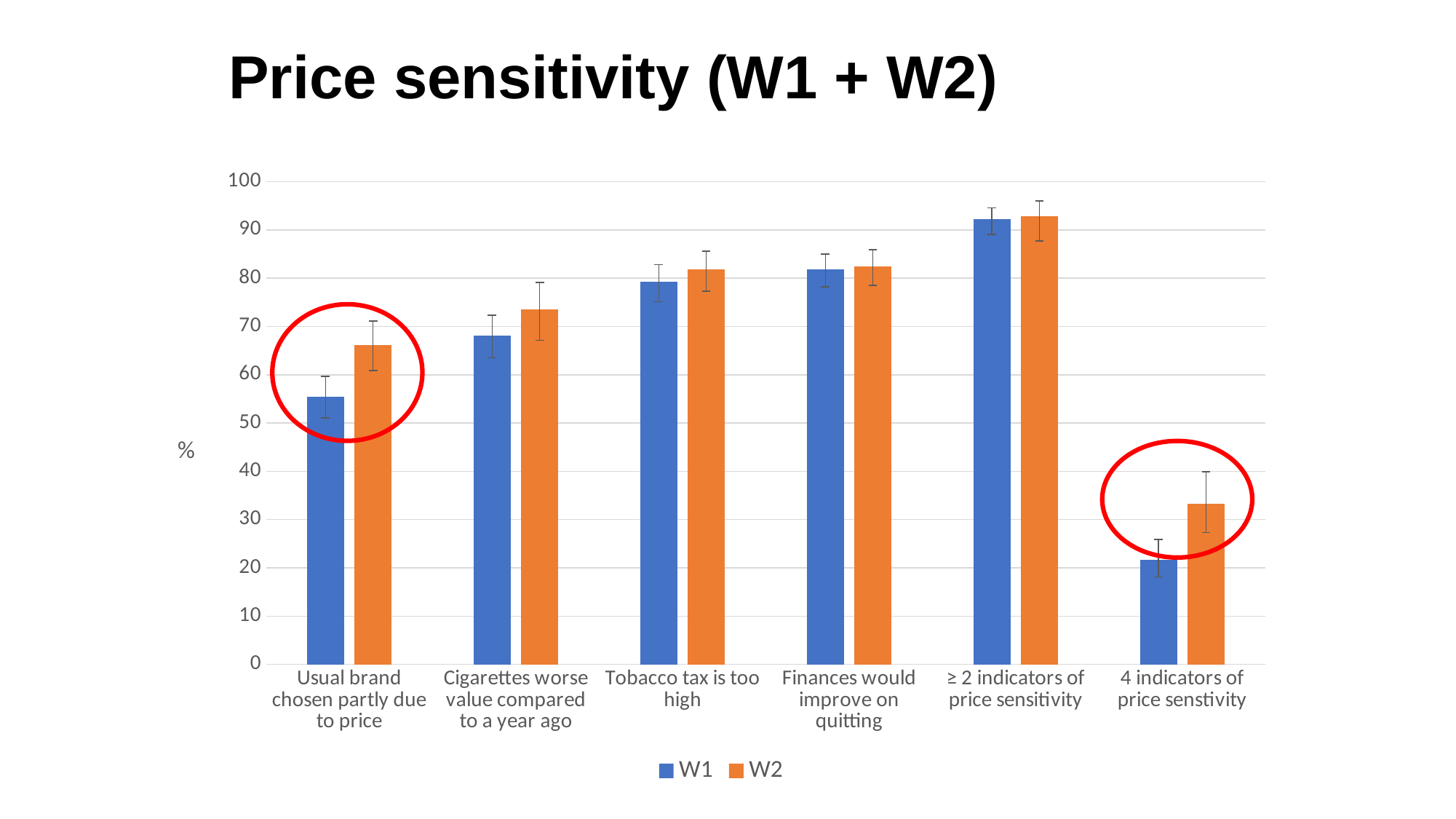
Is the W1 value for 'Usual brand chosen partly due to price' greater or less than 60? less Which category has the highest W1 value? ≥ 2 indicators of price sensitivity For 'Usual brand chosen partly due to price', which series has the larger value, W1 or W2? W2 What is the title of the chart? Price sensitivity (W1 + W2) What type of chart is shown on the slide? bar chart What colour are the W2 bars? orange How many categories are shown on the x axis? 6 Which category has the lowest W2 value? 4 indicators of price senstivity Is the W2 value for '4 indicators of price senstivity' greater or less than 30? greater Is the W1 value for '≥ 2 indicators of price sensitivity' greater or less than 90? greater How many series does the legend list? 2 For '4 indicators of price senstivity', which series has the larger value, W1 or W2? W2